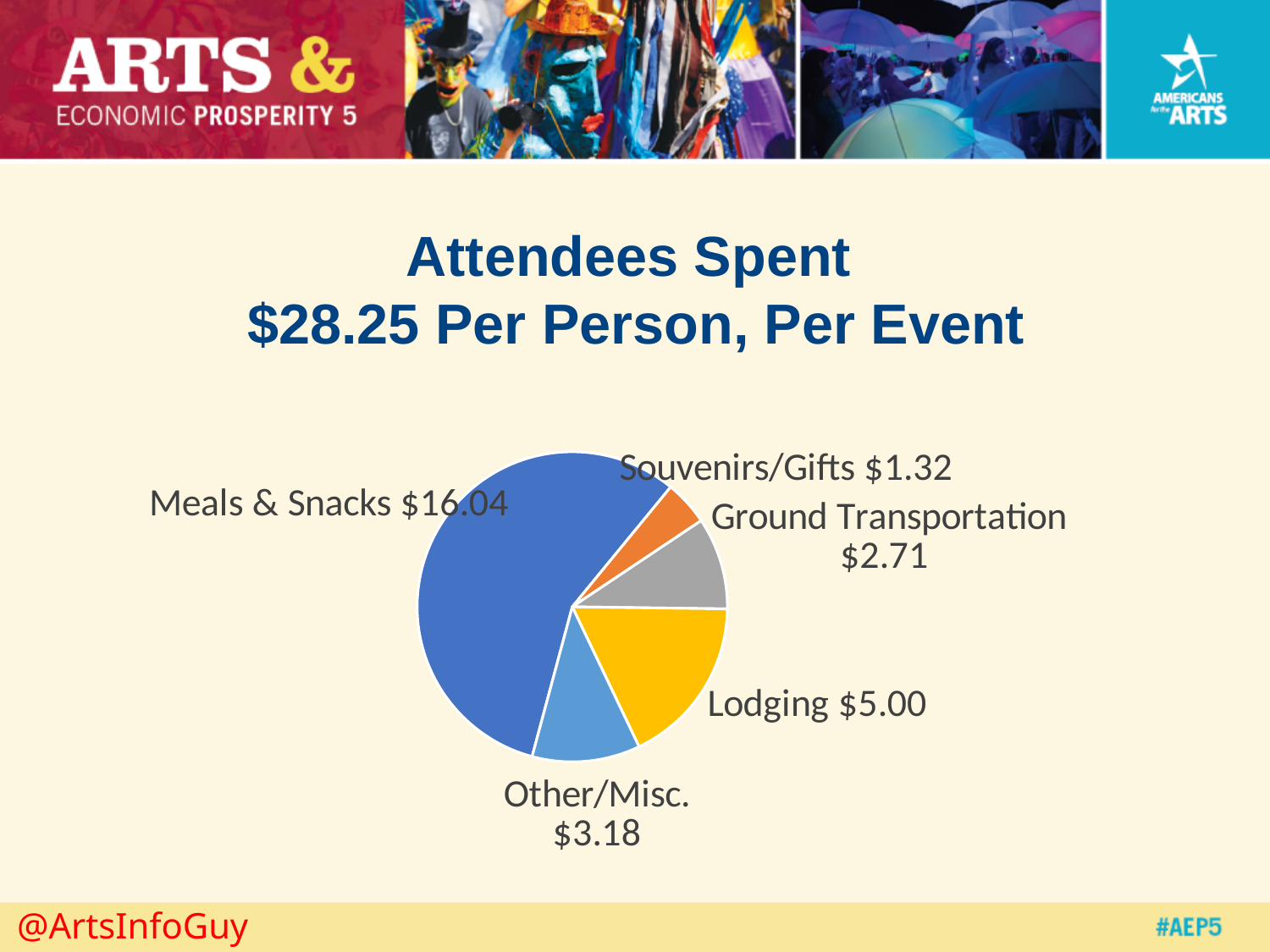
How much did attendees spend on Meals & Snacks per person, per event? $16.04 How much more was spent on Meals & Snacks than on Lodging? $11.04 What colour is the Lodging slice of the pie chart? Yellow What amount is shown for Ground Transportation? $2.71 Which spending category has the smallest slice of the pie chart? Souvenirs/Gifts What type of chart is shown on the slide? Pie chart What is the difference between Ground Transportation and Souvenirs/Gifts spending? $1.39 What is the value shown for Lodging in the pie chart? $5.00 Which is larger, spending on Lodging or on Other/Misc.? Lodging What is the value for Other/Misc. in the pie chart? $3.18 How many spending categories are shown in the pie chart? 5 Which spending category has the largest slice of the pie chart? Meals & Snacks